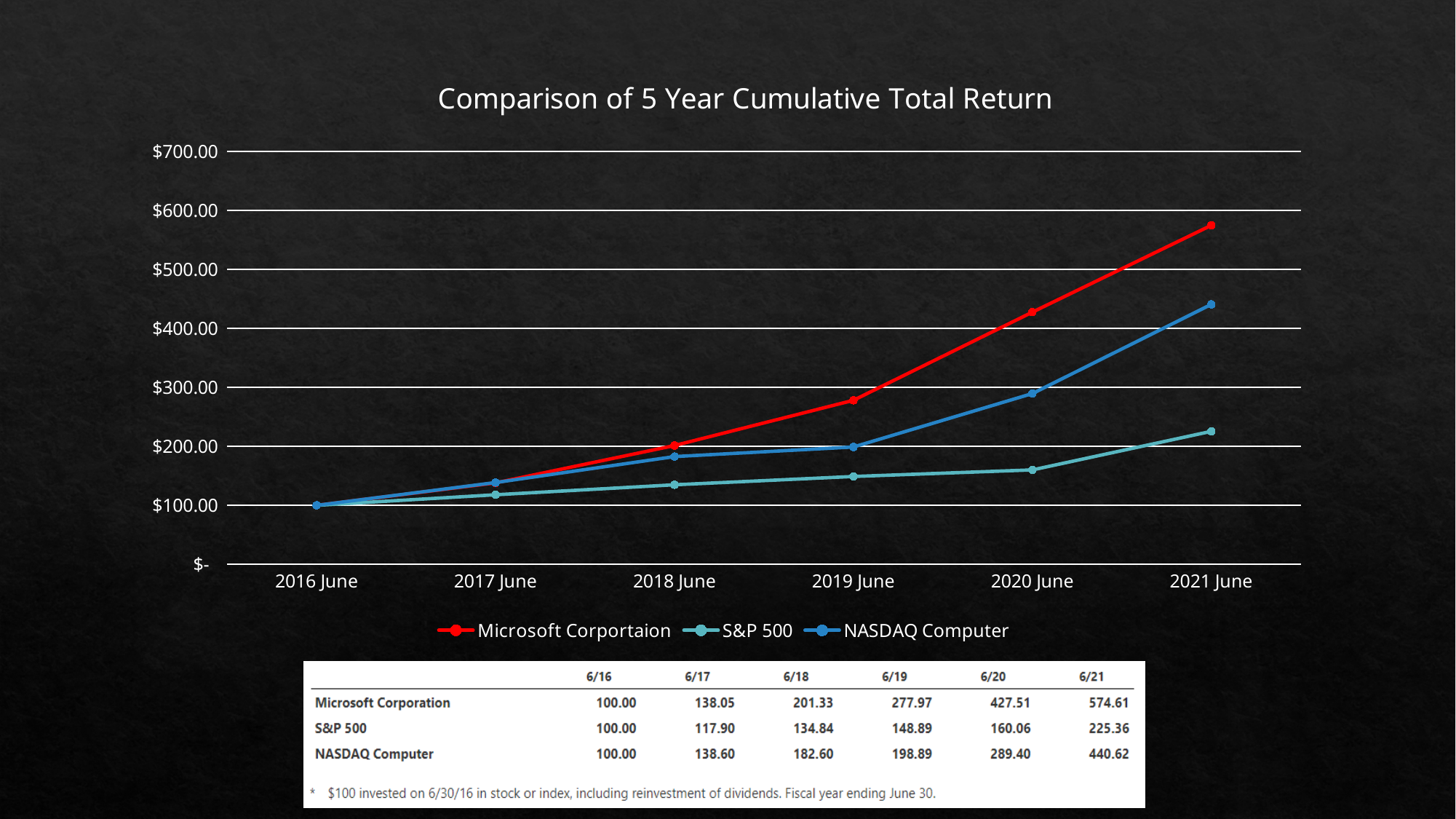
What is the difference between Microsoft Corporation and NASDAQ Computer at 6/21? 133.99 How many series does the legend list? 3 What is the title of the chart? Comparison of 5 Year Cumulative Total Return Which series has the highest value at 2021 June? Microsoft Corporation What is the value for the S&P 500 at 6/19? 148.89 Does the Microsoft Corporation line rise or fall from 2016 June to 2021 June? Rise Which is larger at 6/18, the S&P 500 or NASDAQ Computer? NASDAQ Computer How many time points are plotted along the x axis? 6 What is the value for NASDAQ Computer at 6/20? 289.40 What type of chart is shown on the slide? Line chart What is the value for Microsoft Corporation at 6/21? 574.61 Which series has the lowest value at 2020 June? S&P 500